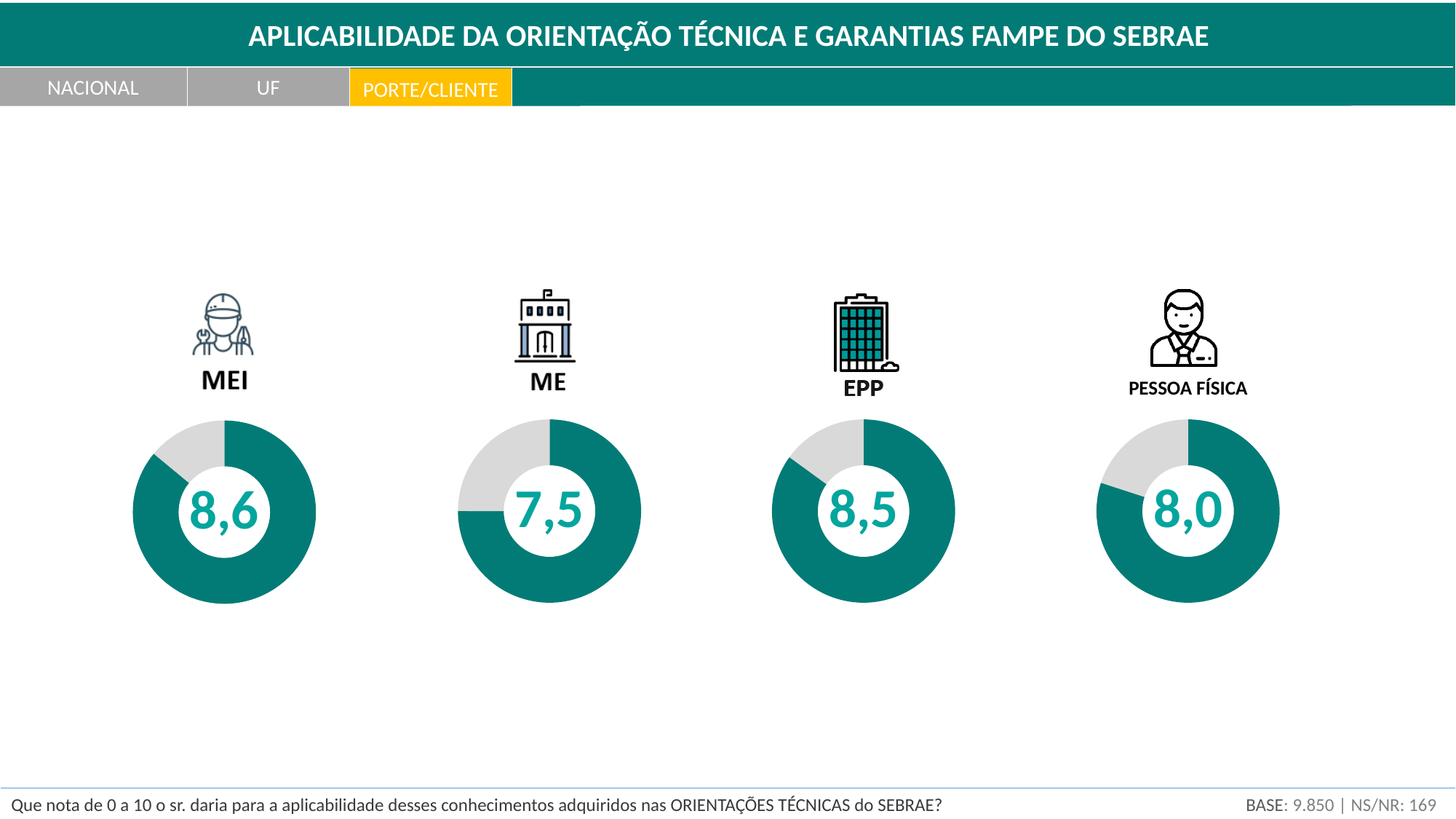
What score is shown in the MEI donut chart? 8,6 What score is shown in the PESSOA FÍSICA donut chart? 8,0 What kind of chart is used to display each group's score? Donut chart What score is shown in the ME donut chart? 7,5 What is the difference between the EPP score and the PESSOA FÍSICA score? 0,5 What score is shown in the EPP donut chart? 8,5 Which score is larger, EPP or PESSOA FÍSICA? EPP Which group has the highest score among the four donut charts? MEI How many donut charts are shown on the slide? 4 What is the difference between the MEI score and the ME score? 1,1 Which group has the lowest score among the four donut charts? ME Which tab is highlighted in yellow at the top of the slide? PORTE/CLIENTE